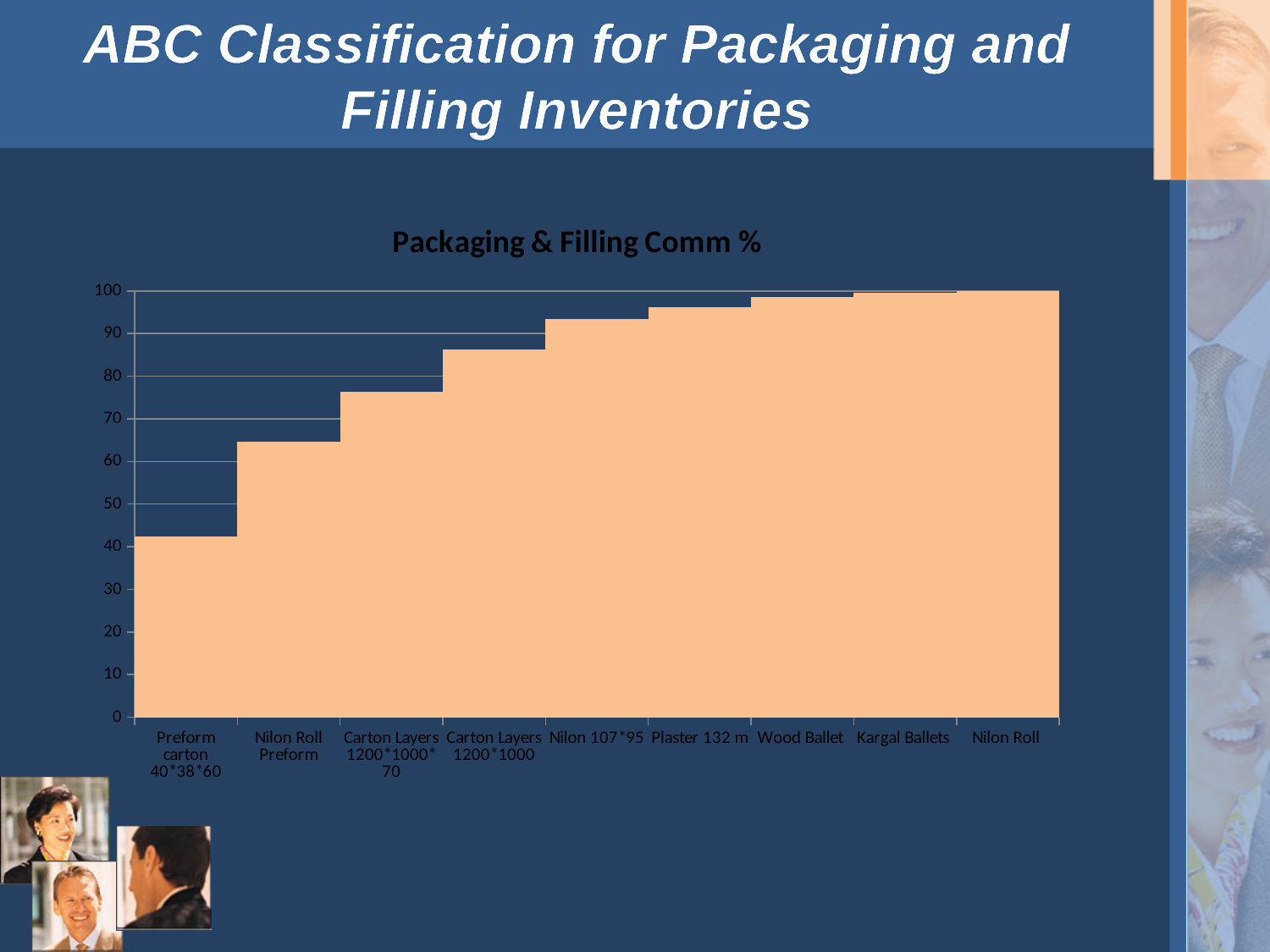
Which has the larger value, Carton Layers 1200*1000*70 or Carton Layers 1200*1000? Carton Layers 1200*1000 Is the value for Carton Layers 1200*1000*70 greater or less than 80? less Is the value for Preform carton 40*38*60 greater or less than 50? less Is the value for Nilon 107*95 greater or less than 90? greater Which has the larger value, Preform carton 40*38*60 or Nilon Roll Preform? Nilon Roll Preform What kind of chart is shown on the slide? bar chart What is the title of the chart? Packaging & Filling Comm % Which category has the lowest value in the chart? Preform carton 40*38*60 Do the values rise or fall moving left to right along the x axis? rise How many categories are shown on the x axis of the chart? 9